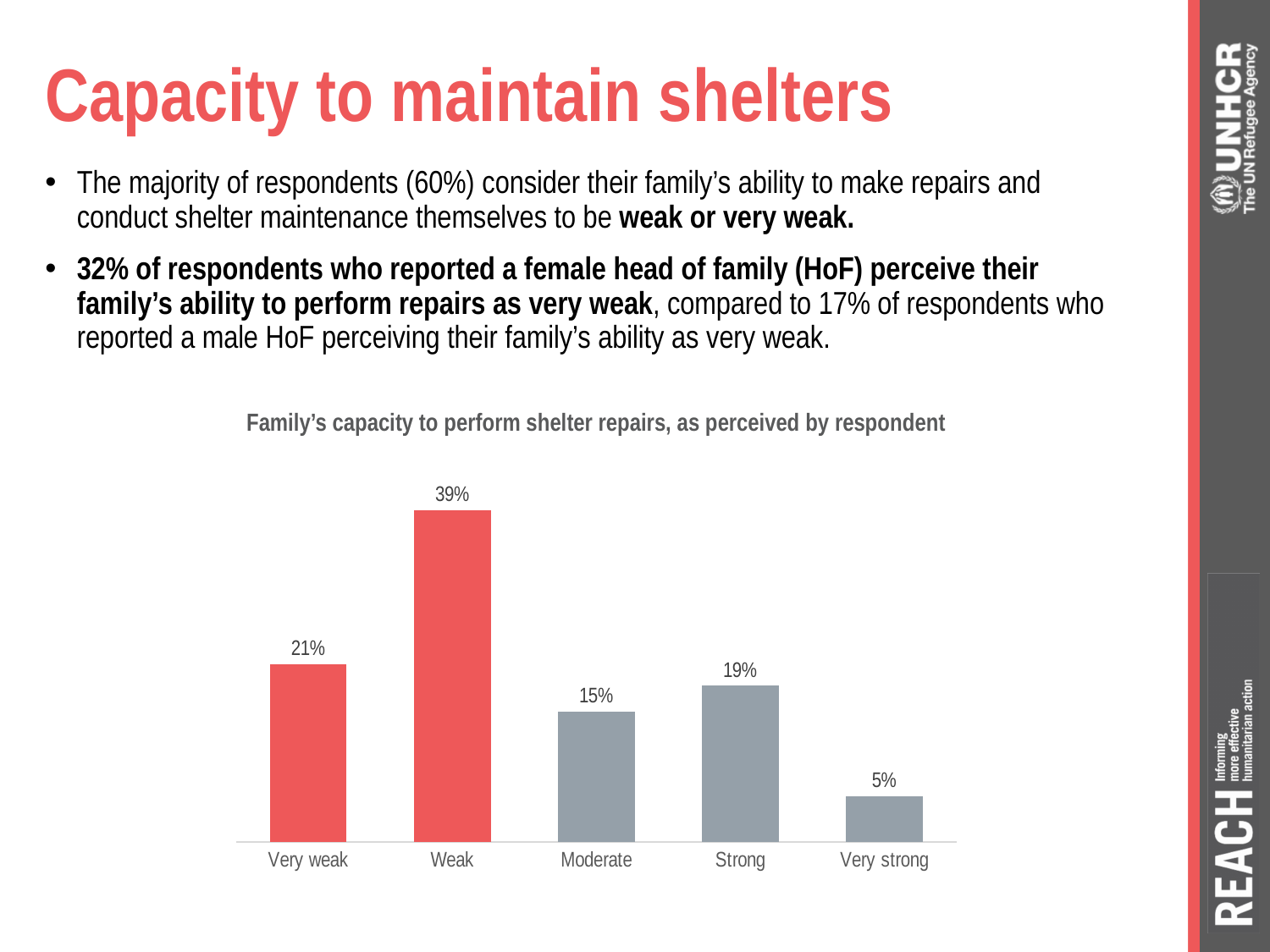
Which category has the highest value in the chart? Weak Which is larger, the value for Very weak or the value for Strong? Very weak What is the value shown for the Very strong category? 5% What percentage is shown for the Moderate category? 15% Which category has the lowest value in the chart? Very strong What percentage of respondents perceive their family's capacity to perform shelter repairs as Weak? 39% How many categories are shown on the x axis of the chart? 5 What is the title of the chart? Family's capacity to perform shelter repairs, as perceived by respondent What is the difference between the Strong and Moderate values? 4% What is the difference between the Weak and Very weak values? 18% What kind of chart is shown on the slide? Bar chart Which bars in the chart are coloured red? Very weak and Weak